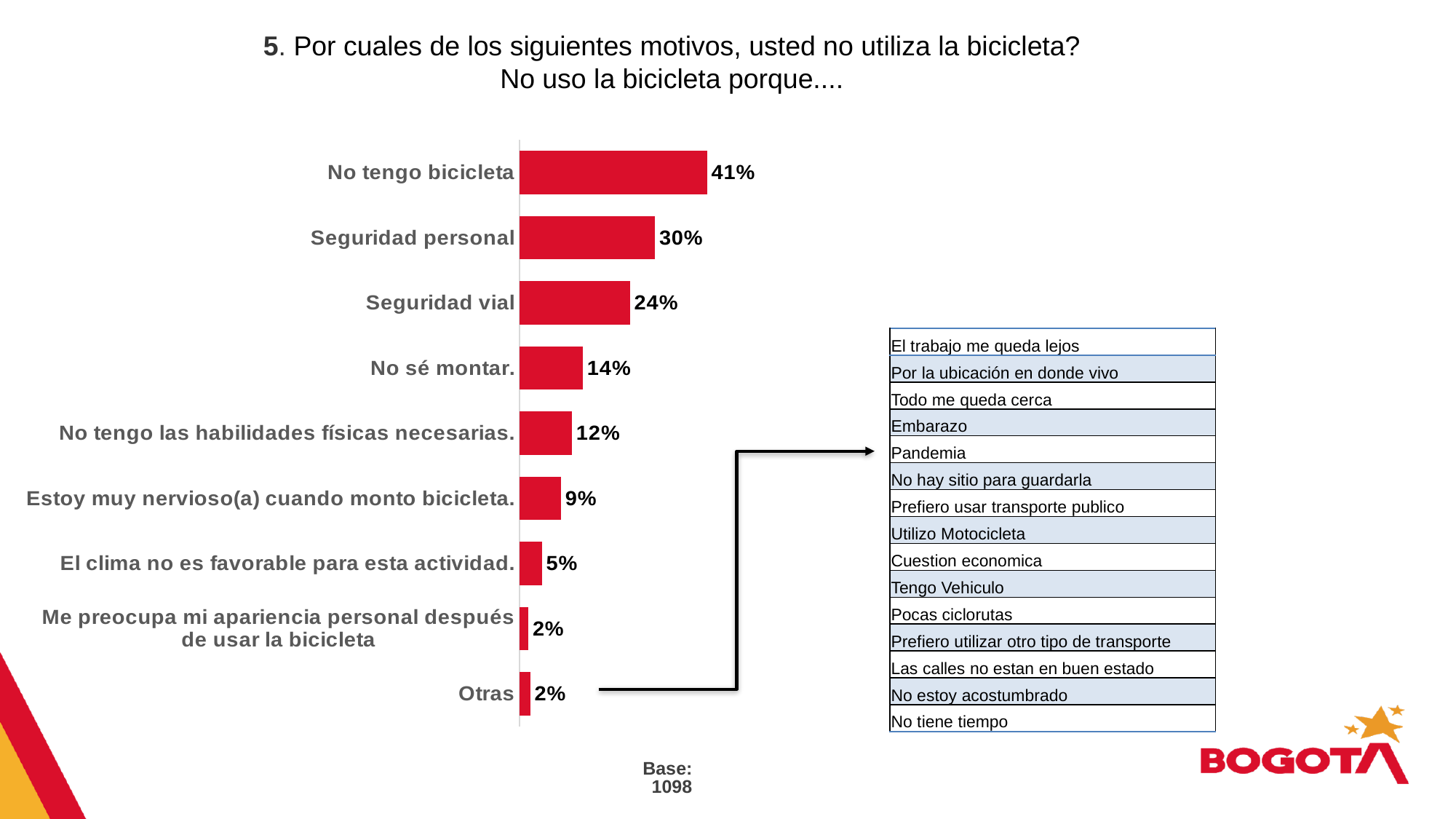
What percentage of respondents said "No tengo bicicleta"? 41% What is the value for "Estoy muy nervioso(a) cuando monto bicicleta."? 9% Which reason has the highest percentage? No tengo bicicleta What is the value for "Seguridad vial"? 24% Which is larger, "Seguridad personal" or "Seguridad vial"? Seguridad personal What is the difference between "No tengo bicicleta" and "Seguridad personal"? 11% What is the difference between "No sé montar." and "No tengo las habilidades físicas necesarias."? 2% What is the value for "El clima no es favorable para esta actividad."? 5% How many categories (bars) does the chart show? 9 What kind of chart is shown on the slide? Bar chart What colour are the bars in the chart? Red What is the base (number of respondents) shown below the chart? 1098